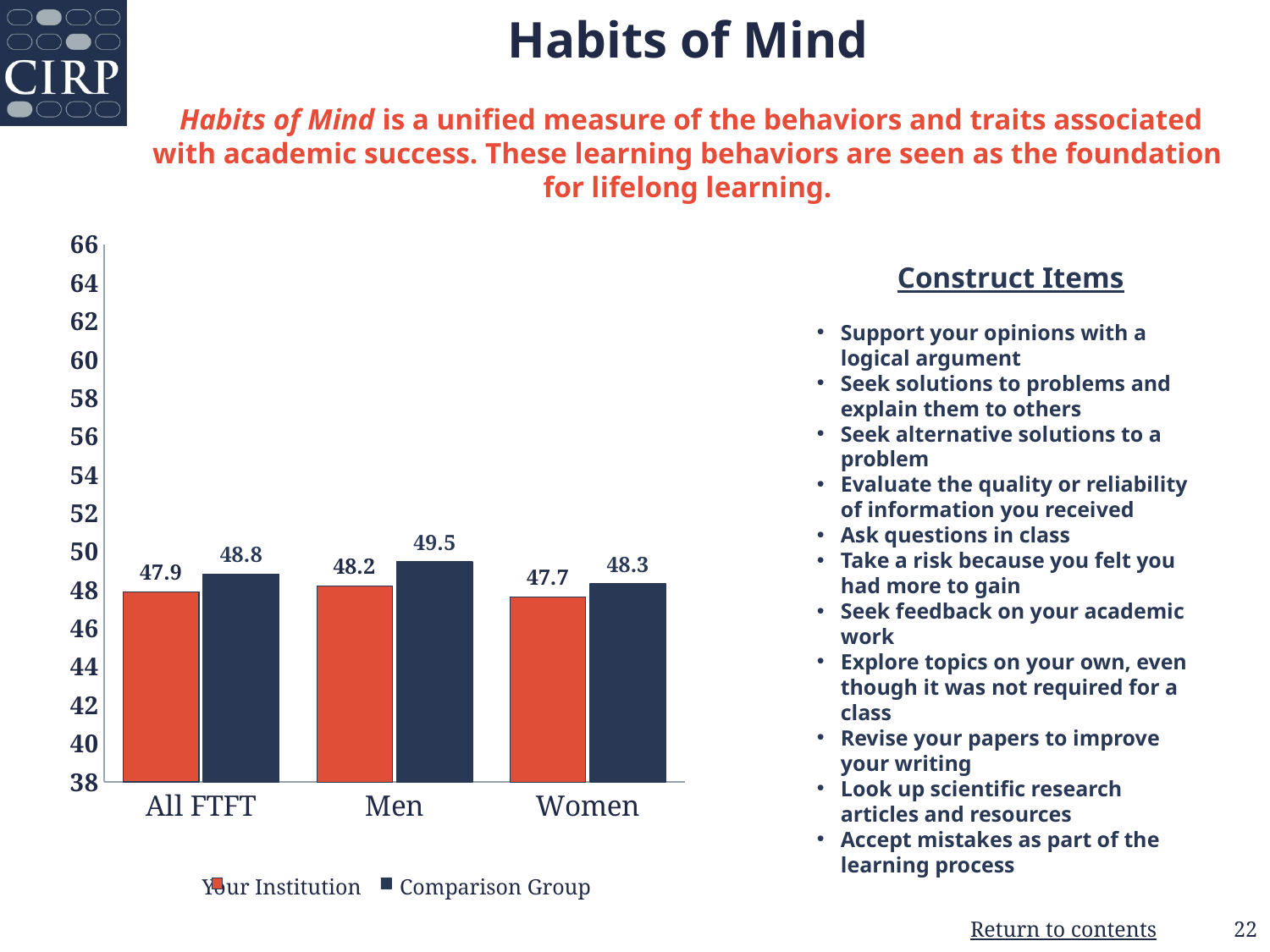
What is the value for Comparison Group in the Women category? 48.3 What are the two series named in the legend? Your Institution and Comparison Group How many series does the legend list? 2 Which category has the lowest Your Institution value? Women What is the difference between the Comparison Group and Your Institution values for Men? 1.3 Which is larger for All FTFT: Your Institution or Comparison Group? Comparison Group What is the value for Your Institution in the All FTFT category? 47.9 What is the value for Your Institution in the Women category? 47.7 Which category has the highest Comparison Group value? Men What kind of chart is shown on the slide? Bar chart How many categories are shown on the x axis? 3 What is the value for Comparison Group in the Men category? 49.5